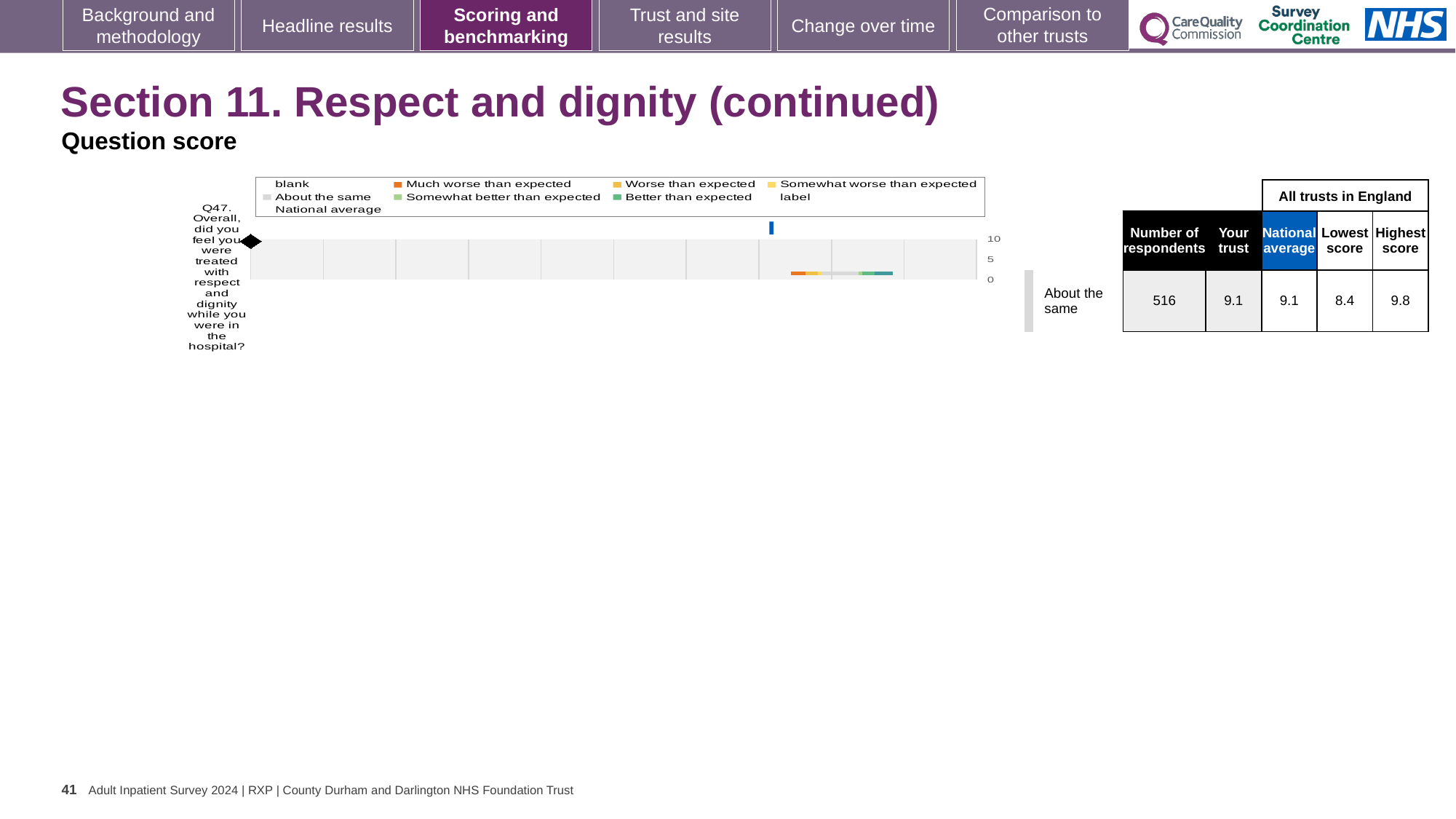
What is the Highest score among all trusts in England for Q47? 9.8 Which benchmarking category is Q47 placed in for this trust? About the same Is Your trust's score for Q47 higher than, lower than, or the same as the National average? the same How many respondents answered Q47? 516 What is the difference between the Highest score and the Lowest score for Q47? 1.4 What is the Lowest score among all trusts in England for Q47? 8.4 Is Your trust's score for Q47 greater or less than 5 on the chart's axis? greater What is the National average score for Q47? 9.1 What is the score for Your trust on Q47 (treated with respect and dignity)? 9.1 By how much does the Highest score exceed Your trust's score for Q47? 0.7 What kind of chart is shown on the slide? bar chart How many survey questions are plotted on the chart? 1